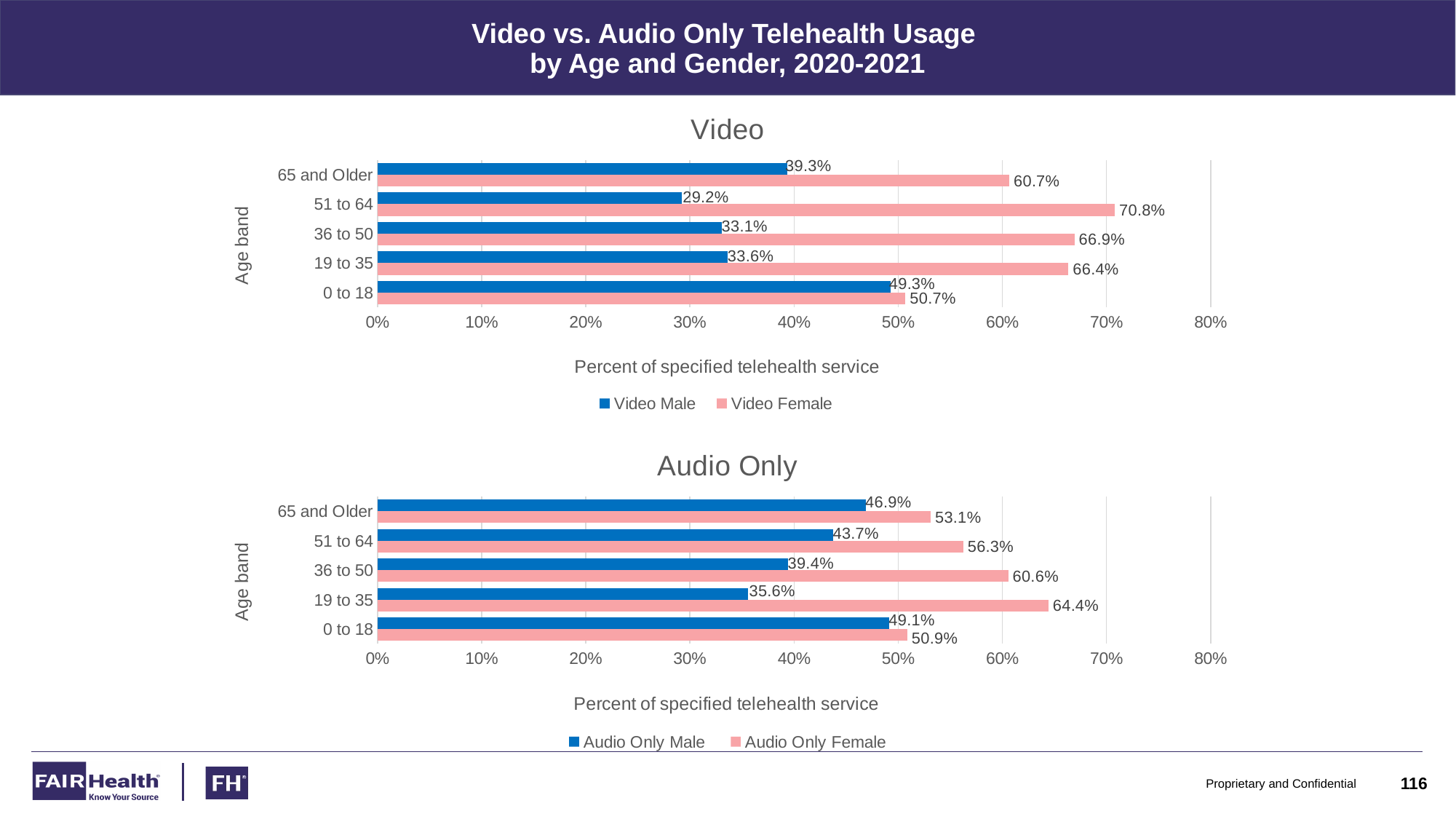
In the Video chart, what is the Video Female value for 51 to 64? 70.8% How many age bands are shown in the Audio Only chart? 5 In the Audio Only chart, which age band has the highest Audio Only Female value? 19 to 35 In the Audio Only chart, which is larger for 36 to 50: the Audio Only Male value or the Audio Only Female value? Audio Only Female In the Audio Only chart, what is the total of the Audio Only Male and Audio Only Female values for 0 to 18? 100.0% What kind of chart is the Audio Only chart? Bar chart How many series does the legend of the Video chart list? 2 In the Audio Only chart, what is the Audio Only Male value for 19 to 35? 35.6% In the Video chart, which age band has the lowest Video Male value? 51 to 64 What is the x-axis label of the Video chart? Percent of specified telehealth service In the Video chart, what is the difference between the Video Female and Video Male values for 65 and Older? 21.4% In the Video chart, is the Video Female value for 36 to 50 greater or less than 60%? greater